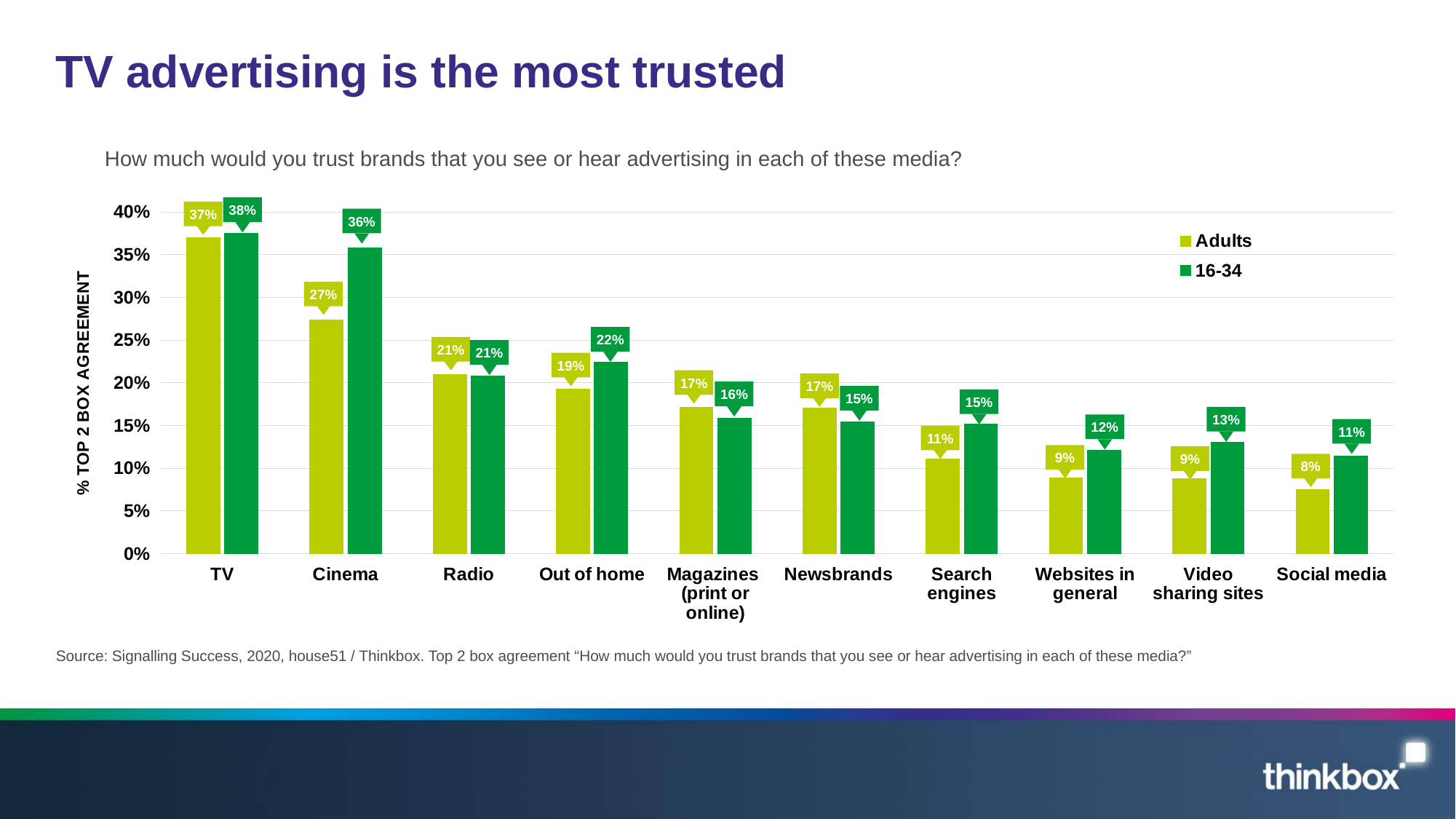
What is the value for 16-34 for Video sharing sites? 13% Which category has the lowest value for the Adults series? Social media Which category has the highest value for the 16-34 series? TV What kind of chart is shown on the slide? Bar chart What is the value for 16-34 for Cinema? 36% Which is larger for Search engines: the Adults value or the 16-34 value? 16-34 How many media categories are shown on the x axis? 10 What is the label of the vertical axis? % TOP 2 BOX AGREEMENT What is the value for Adults for TV? 37% What is the difference between the Adults and 16-34 values for Cinema? 9% What is the value for Adults for Social media? 8% How many series does the legend list? 2